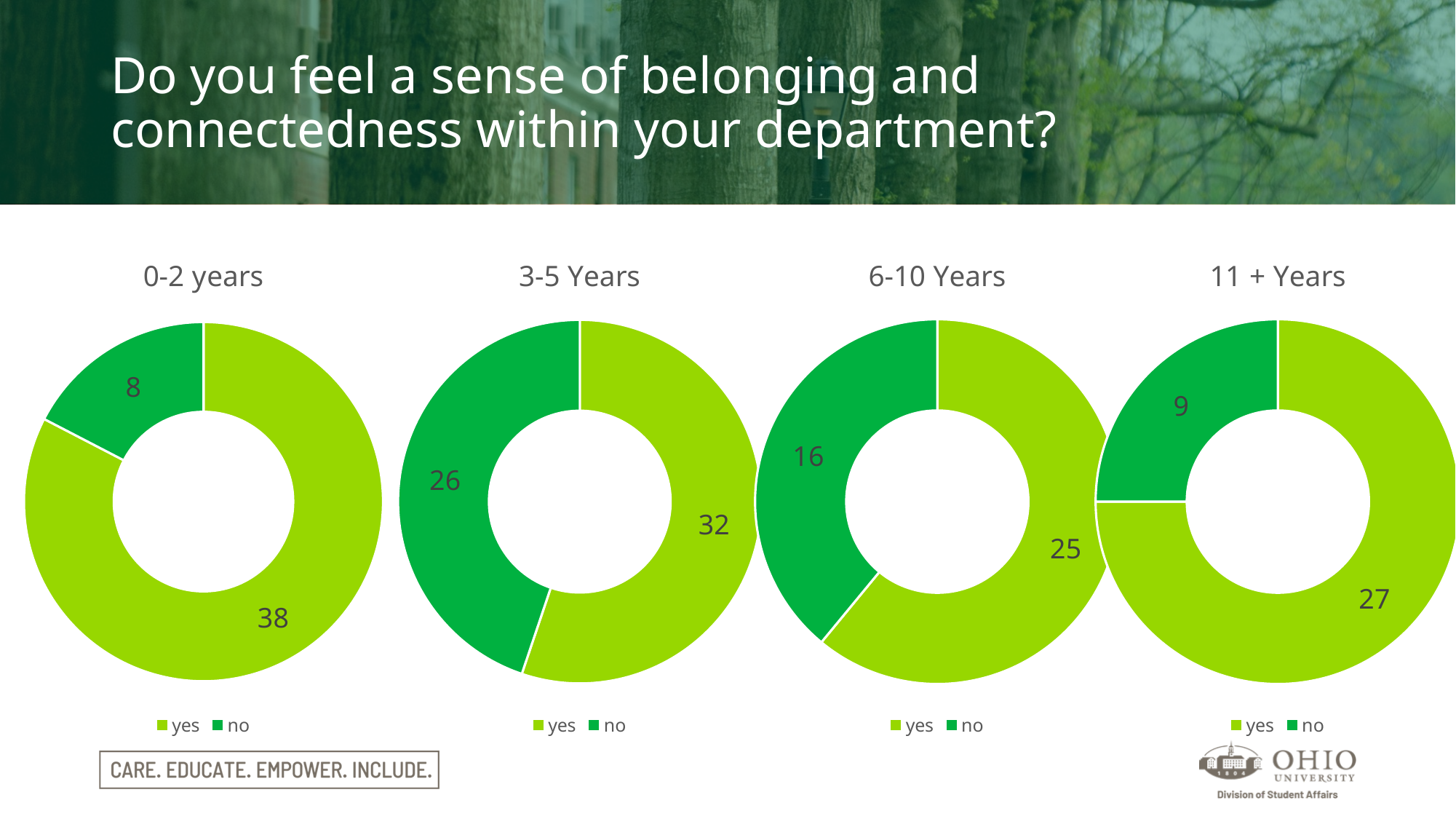
In the "0-2 years" chart, what is the value for "no"? 8 In the "6-10 Years" chart, which is larger, "yes" or "no"? yes What kind of chart is the "0-2 years" chart? doughnut chart In the "11 + Years" chart, what is the value for "no"? 9 How many entries does the legend of the "3-5 Years" chart list? 2 In the "0-2 years" chart, what is the value for "yes"? 38 In the "11 + Years" chart, what share of the total does "yes" represent? 75% In the "6-10 Years" chart, what is the value for "yes"? 25 In the "3-5 Years" chart, what is the difference between the "yes" and "no" values? 6 How many charts are shown on the slide? 4 In the "3-5 Years" chart, what is the value for "no"? 26 In the "0-2 years" chart, what is the difference between the "yes" and "no" values? 30